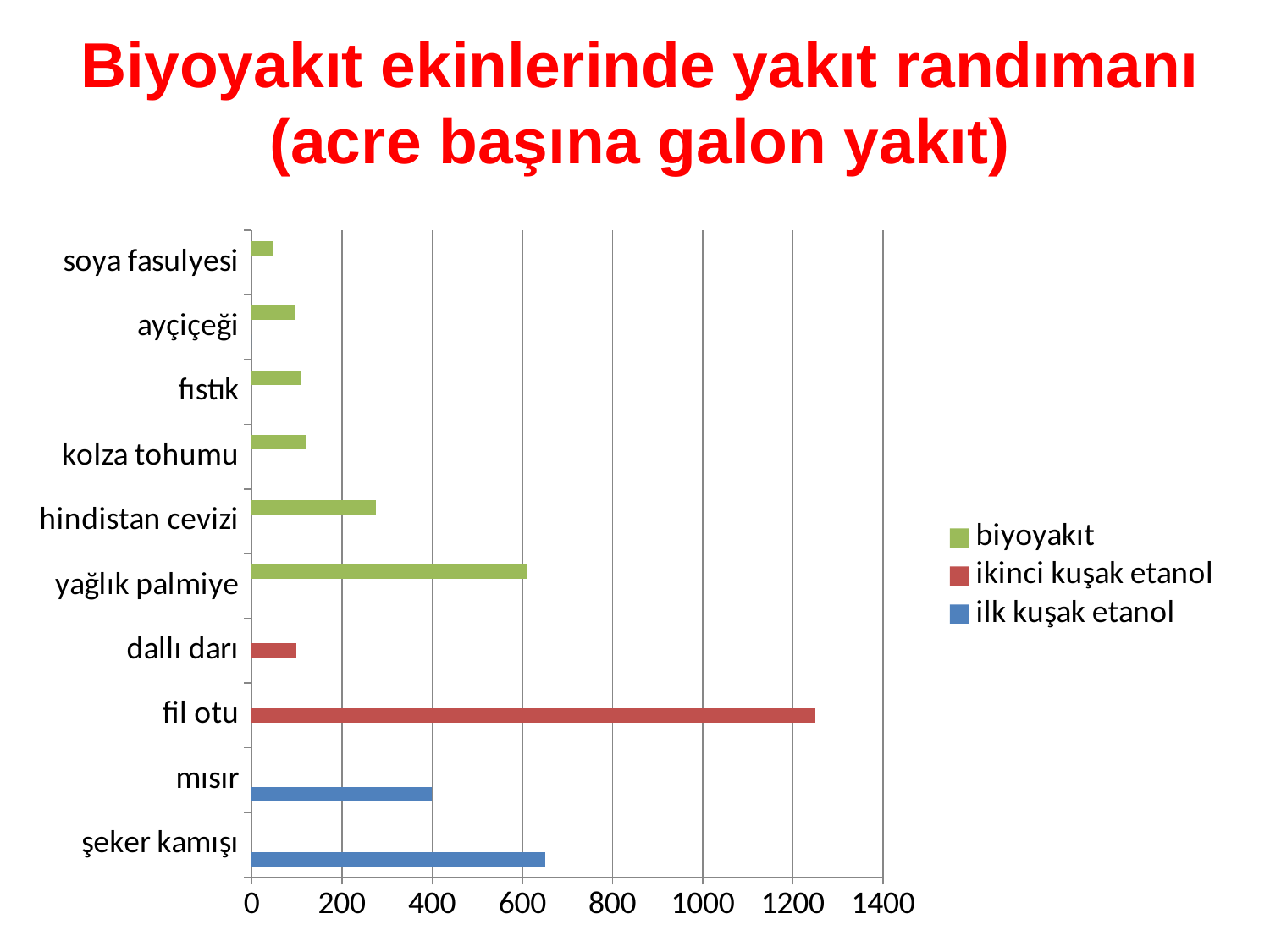
Is the value for hindistan cevizi greater or less than 200? greater Which crop has the lowest value on the chart? soya fasulyesi How many crop categories are plotted on the chart? 10 Is the value for fil otu greater or less than 1200? greater Which series does the fil otu bar belong to, according to the legend colours? ikinci kuşak etanol Which series is shown in green in the legend? biyoyakıt Which has a larger value, yağlık palmiye or hindistan cevizi? yağlık palmiye Which crop has the highest value on the chart? fil otu How many series does the legend list? 3 Which has a larger value, şeker kamışı or mısır? şeker kamışı What kind of chart is shown on the slide? bar chart Is the value for soya fasulyesi greater or less than 100? less